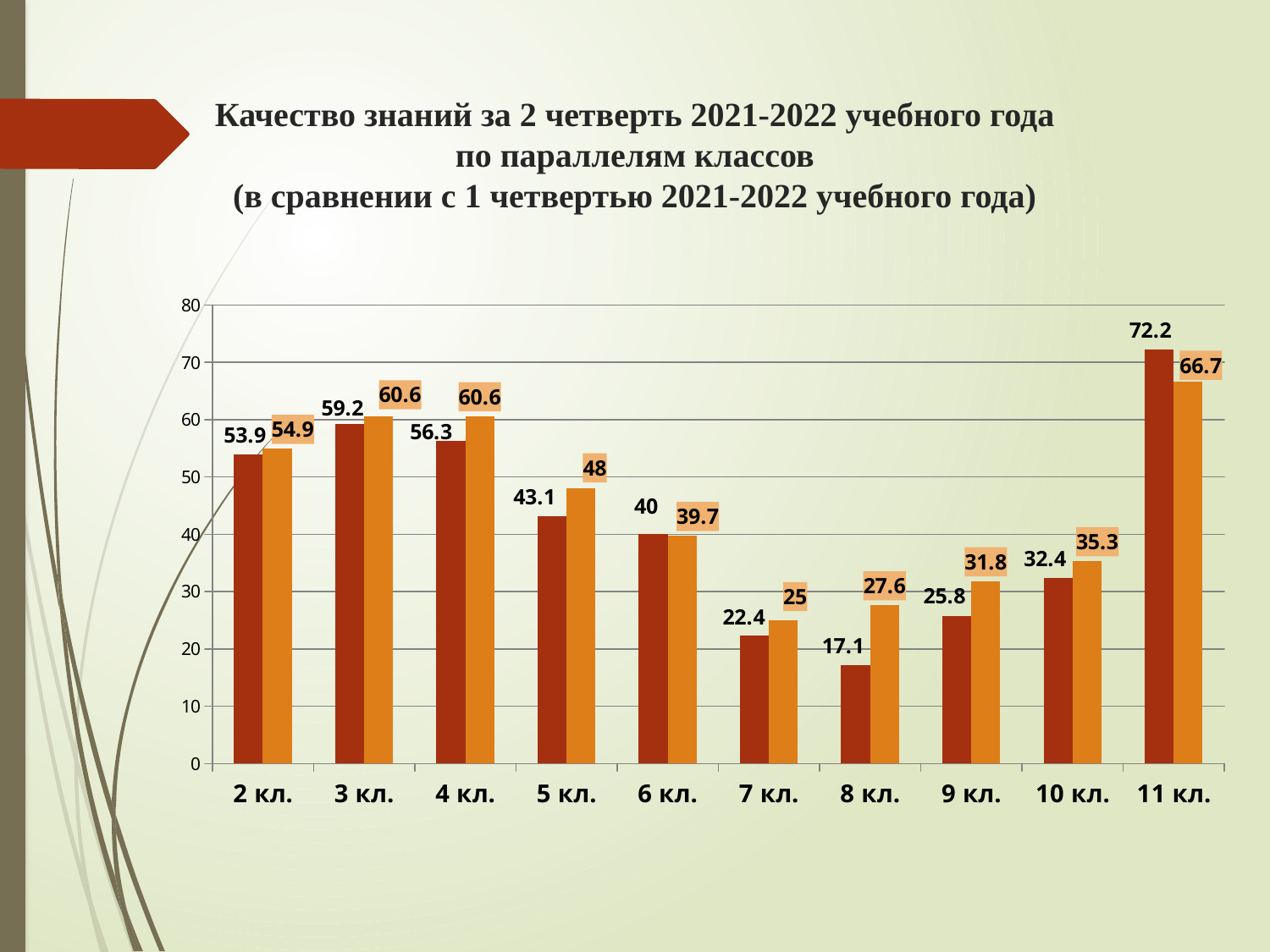
Is the dark red bar for 9 кл. greater or less than 30? less Which class has the lowest orange bar? 7 кл. What is the value of the dark red bar for 4 кл.? 56.3 Which class has the lowest dark red bar? 8 кл. What is the difference between the orange bar and the dark red bar for 8 кл.? 10.5 For 11 кл., which bar is larger, the dark red bar or the orange bar? the dark red bar What type of chart is shown on the slide? bar chart What is the value of the orange bar for 5 кл.? 48 Which class has the highest dark red bar? 11 кл. What is the difference between the dark red bar for 11 кл. and the dark red bar for 3 кл.? 13 How many class categories are shown on the x axis? 10 What is the value of the orange bar for 8 кл.? 27.6